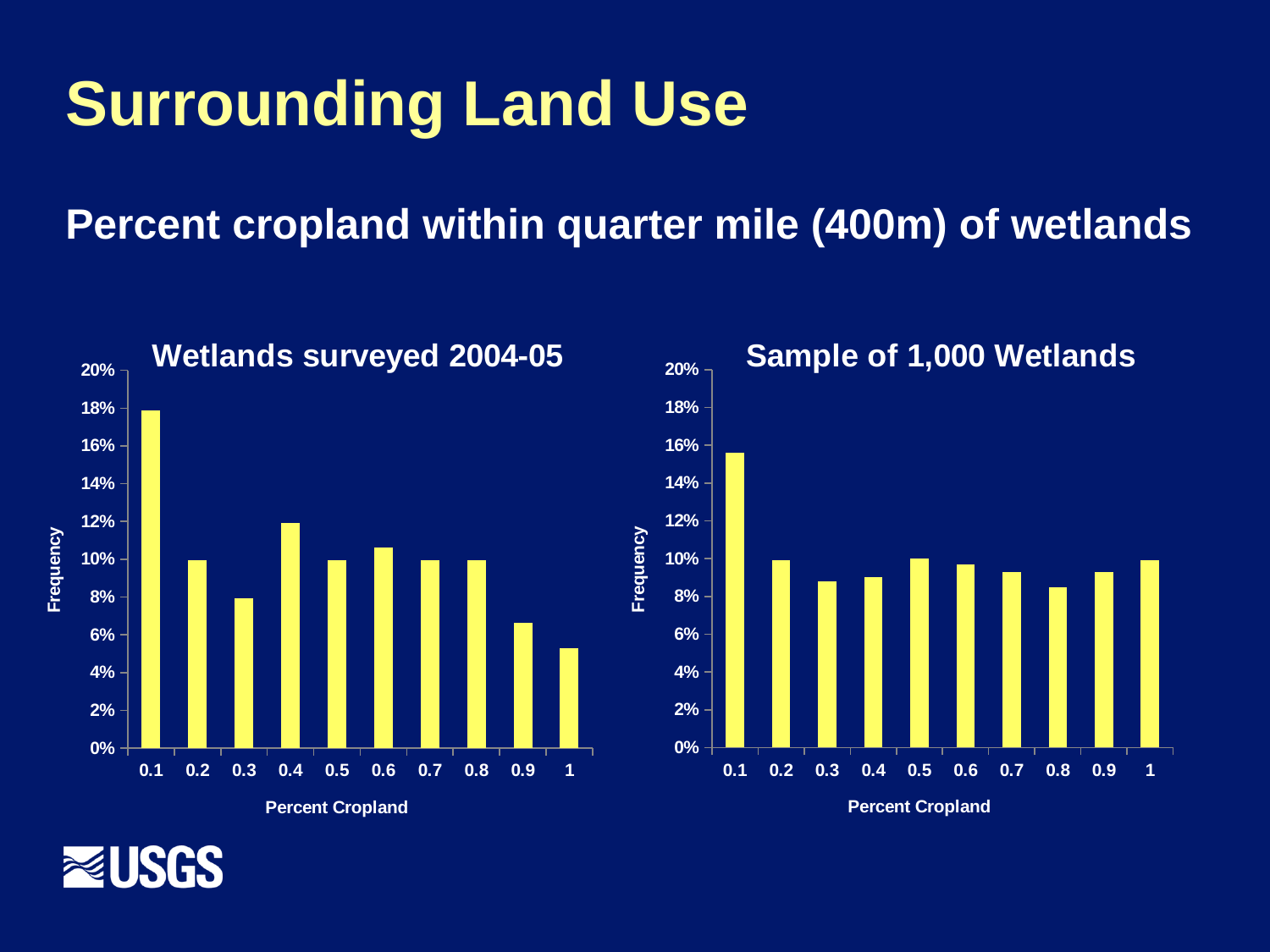
In the 'Wetlands surveyed 2004-05' chart, is the frequency for 0.9 greater or less than 8%? less In the 'Wetlands surveyed 2004-05' chart, is the frequency for 1 greater or less than 6%? less In the 'Wetlands surveyed 2004-05' chart, which percent cropland category has the highest frequency? 0.1 In the 'Sample of 1,000 Wetlands' chart, is the frequency for 0.8 greater or less than 10%? less How many percent cropland categories are shown in the 'Sample of 1,000 Wetlands' chart? 10 In the 'Wetlands surveyed 2004-05' chart, which percent cropland category has the lowest frequency? 1 What kind of chart is the 'Wetlands surveyed 2004-05' chart? Bar chart In the 'Wetlands surveyed 2004-05' chart, which has the higher frequency, 0.3 or 0.4? 0.4 What is the y-axis label on the 'Sample of 1,000 Wetlands' chart? Frequency In the 'Sample of 1,000 Wetlands' chart, which percent cropland category has the highest frequency? 0.1